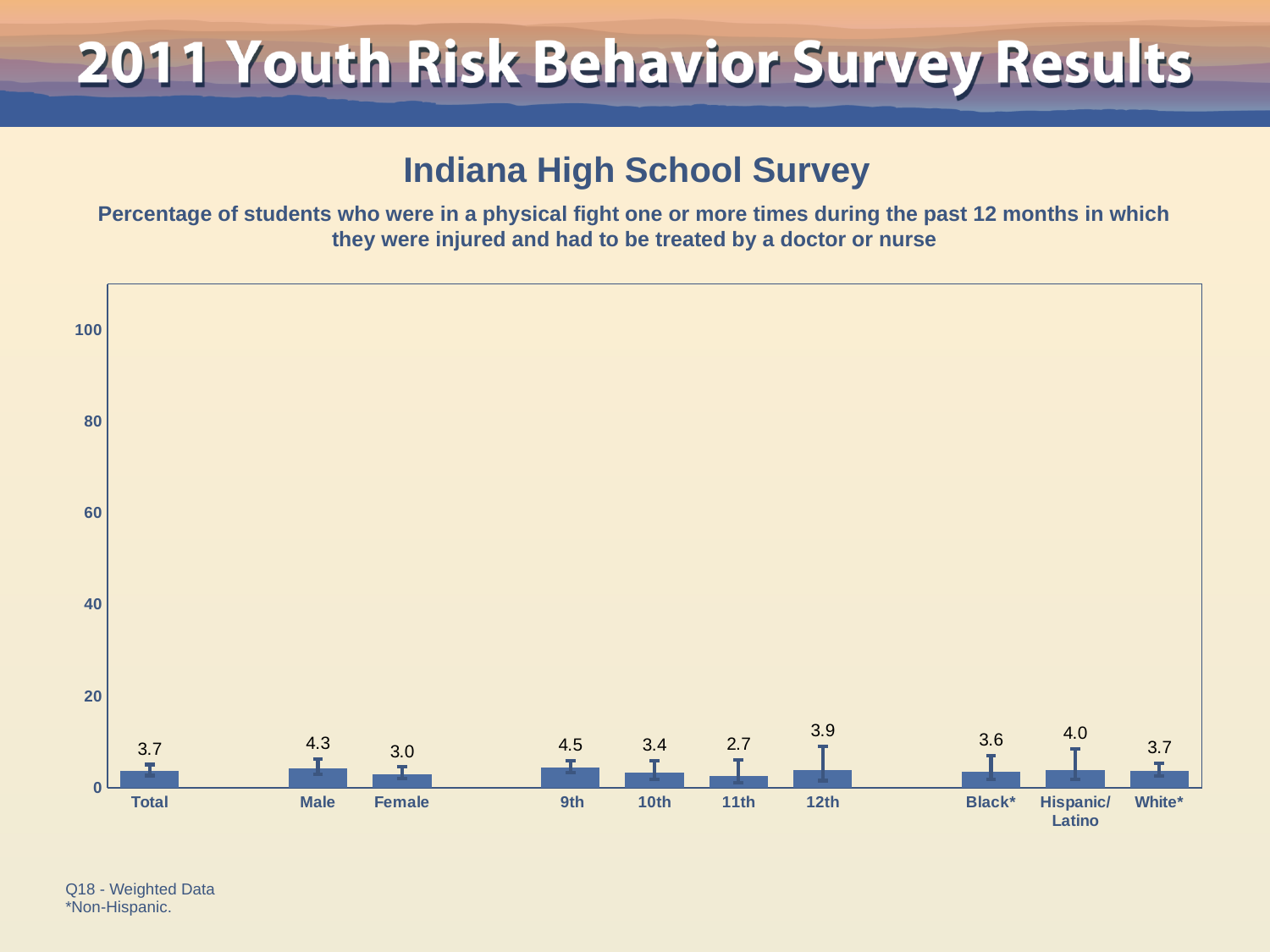
What is the value for 11th? 2.7 What is the value for Hispanic/Latino? 4.0 How many categories are shown on the x axis? 10 What is the difference between the values for Male and Female? 1.3 What kind of chart is shown on the slide? bar chart What is the value for Total? 3.7 What is the value for Male? 4.3 Is the value for Black* greater or less than 20? less Which is larger, the value for 12th or the value for 10th? 12th Which category has the highest value? 9th What is the highest value labelled on the y axis? 100 Which category has the lowest value? 11th